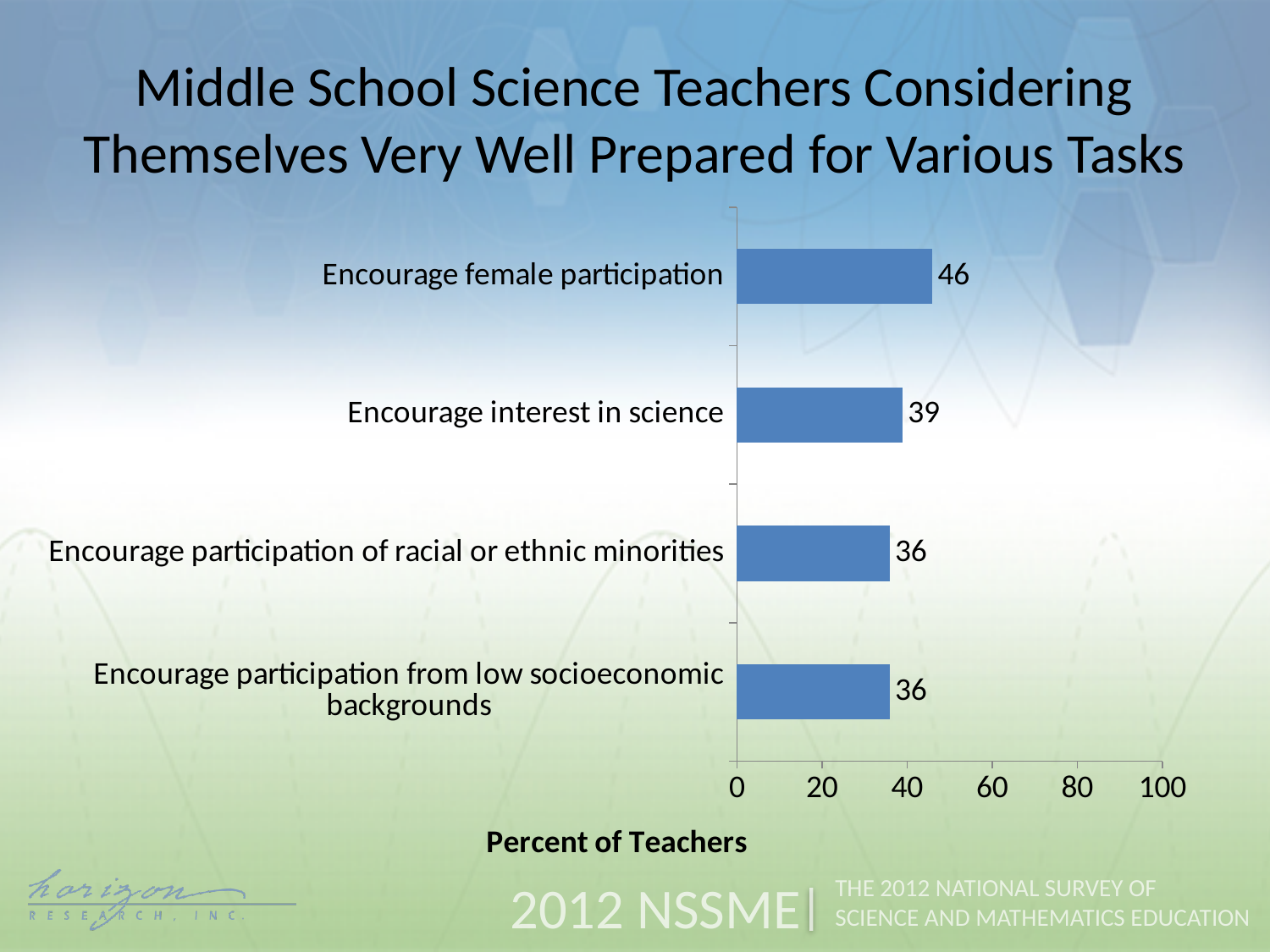
Is the value for 'Encourage female participation' greater or less than 40? greater What is the difference between the values for 'Encourage interest in science' and 'Encourage participation of racial or ethnic minorities'? 3 Which task has the highest percent of teachers considering themselves very well prepared? Encourage female participation What percent of teachers consider themselves very well prepared to encourage female participation? 46 How many tasks (categories) are shown in the chart? 4 What kind of chart is shown on the slide? Bar chart What is the value for 'Encourage participation of racial or ethnic minorities'? 36 Which is larger: the value for 'Encourage female participation' or the value for 'Encourage participation of racial or ethnic minorities'? Encourage female participation What is the label of the horizontal axis? Percent of Teachers What is the difference between the values for 'Encourage female participation' and 'Encourage interest in science'? 7 What is the value for 'Encourage participation from low socioeconomic backgrounds'? 36 What is the value for 'Encourage interest in science'? 39